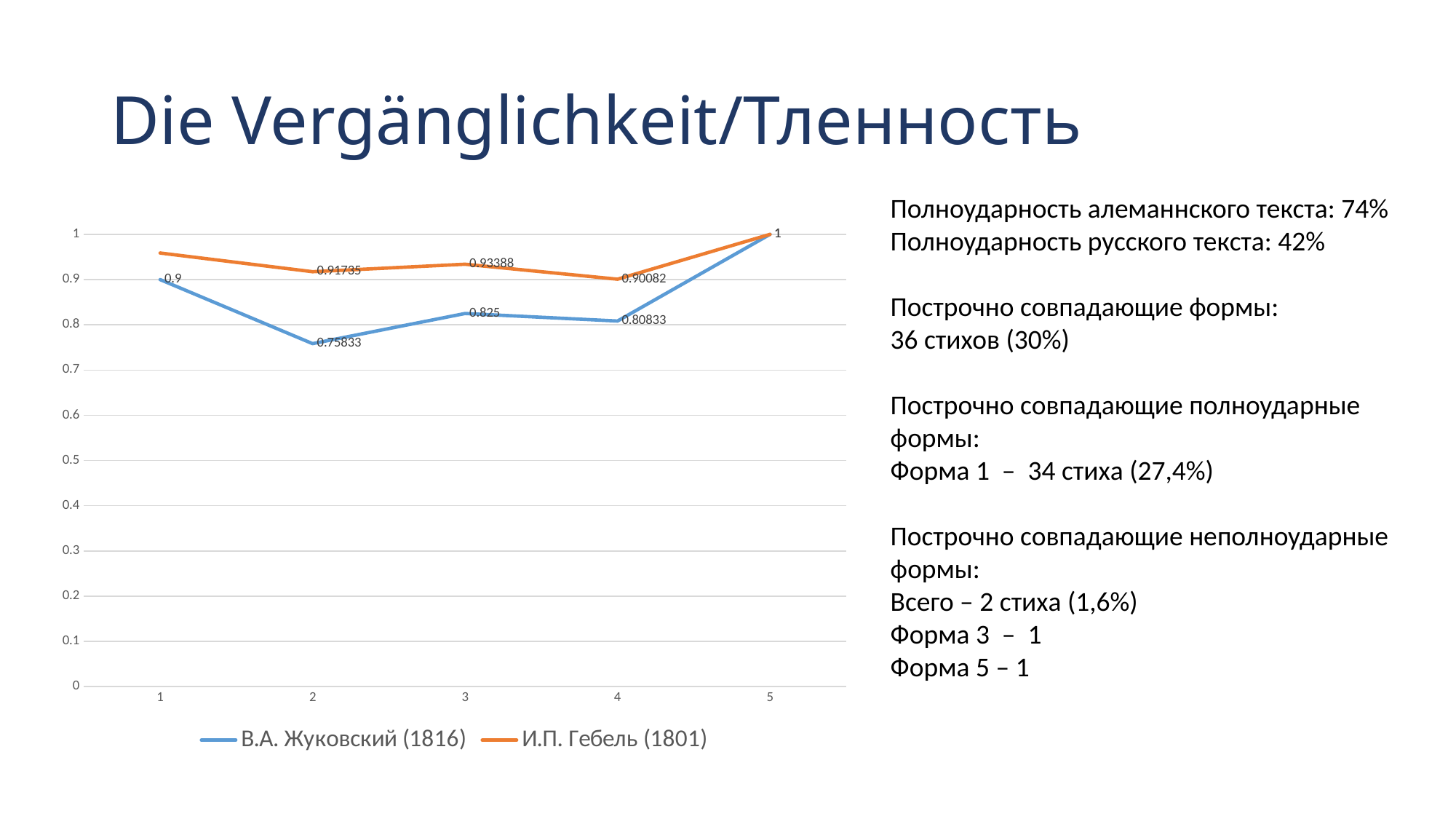
What is the value for В.А. Жуковский (1816) at point 1? 0.9 What is the value for И.П. Гебель (1801) at point 3? 0.93388 How many series does the legend list? 2 At point 2, which series has the higher value, В.А. Жуковский (1816) or И.П. Гебель (1801)? И.П. Гебель (1801) Is the value for И.П. Гебель (1801) at point 1 greater or less than 0.9? greater How many points are plotted along the x axis for each series? 5 At which point on the x axis does И.П. Гебель (1801) reach its lowest value? 4 At which point on the x axis does В.А. Жуковский (1816) reach its lowest value? 2 What is the difference between И.П. Гебель (1801) and В.А. Жуковский (1816) at point 2? 0.15902 What kind of chart is shown on the slide? line chart What is the value for И.П. Гебель (1801) at point 4? 0.90082 What is the value for В.А. Жуковский (1816) at point 2? 0.75833